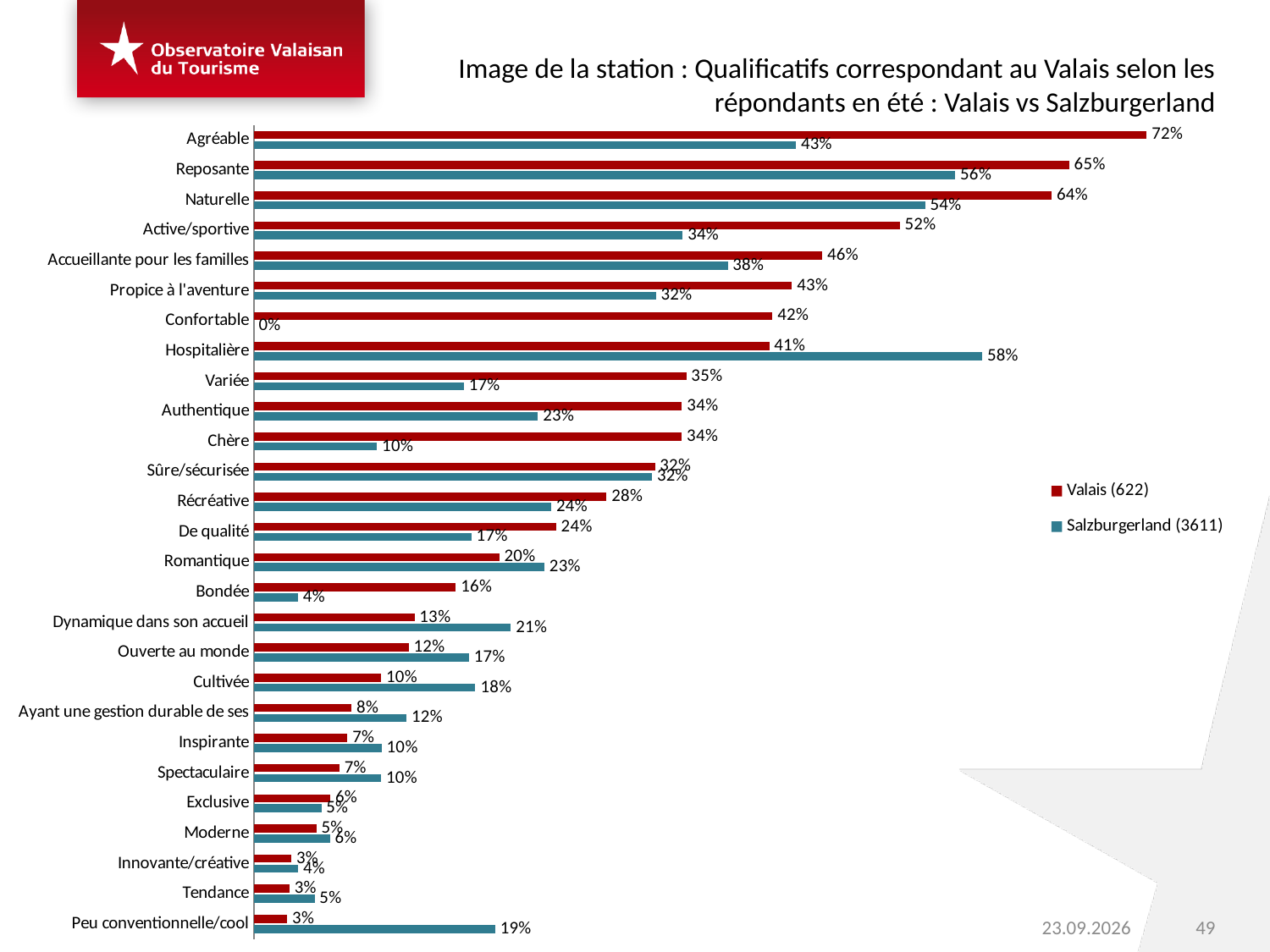
What is the Valais value for Agréable? 72% Which category has the lowest Salzburgerland value? Confortable What is the Salzburgerland value for Peu conventionnelle/cool? 19% What is the difference between the Valais and Salzburgerland values for Chère? 24% Which category has the highest Valais value? Agréable Which category has the highest Salzburgerland value? Hospitalière What is the Salzburgerland value for Hospitalière? 58% How many categories are shown on the chart? 27 How many series does the legend list? 2 Which is larger for Romantique: the Valais value or the Salzburgerland value? Salzburgerland What kind of chart is shown on the slide? Bar chart What are the two series named in the legend? Valais (622) and Salzburgerland (3611)